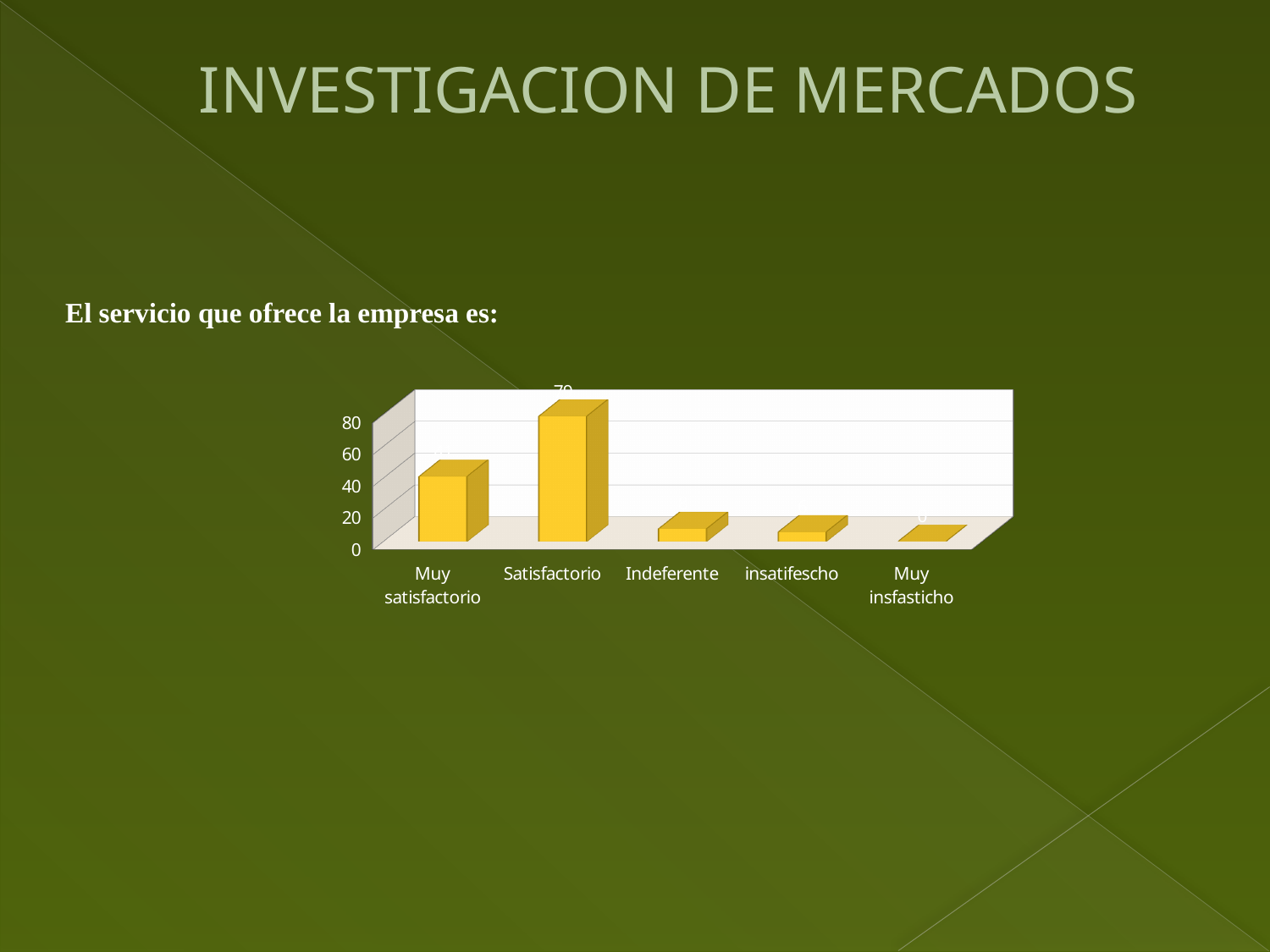
What is the value shown for Satisfactorio? 79 Is the value for insatifescho greater or less than 40? less Which is larger, the value for Muy satisfactorio or the value for Satisfactorio? Satisfactorio Which category has the lowest bar in the chart? Muy insfasticho Is the value for Satisfactorio greater or less than 60? greater Which category has the highest bar in the chart? Satisfactorio Is the value for Indeferente greater or less than 20? less What is the value shown for Muy insfasticho? 0 How many categories are shown on the x axis of the chart? 5 What question or statement is written above the chart? El servicio que ofrece la empresa es: What kind of chart is shown on the slide? bar chart